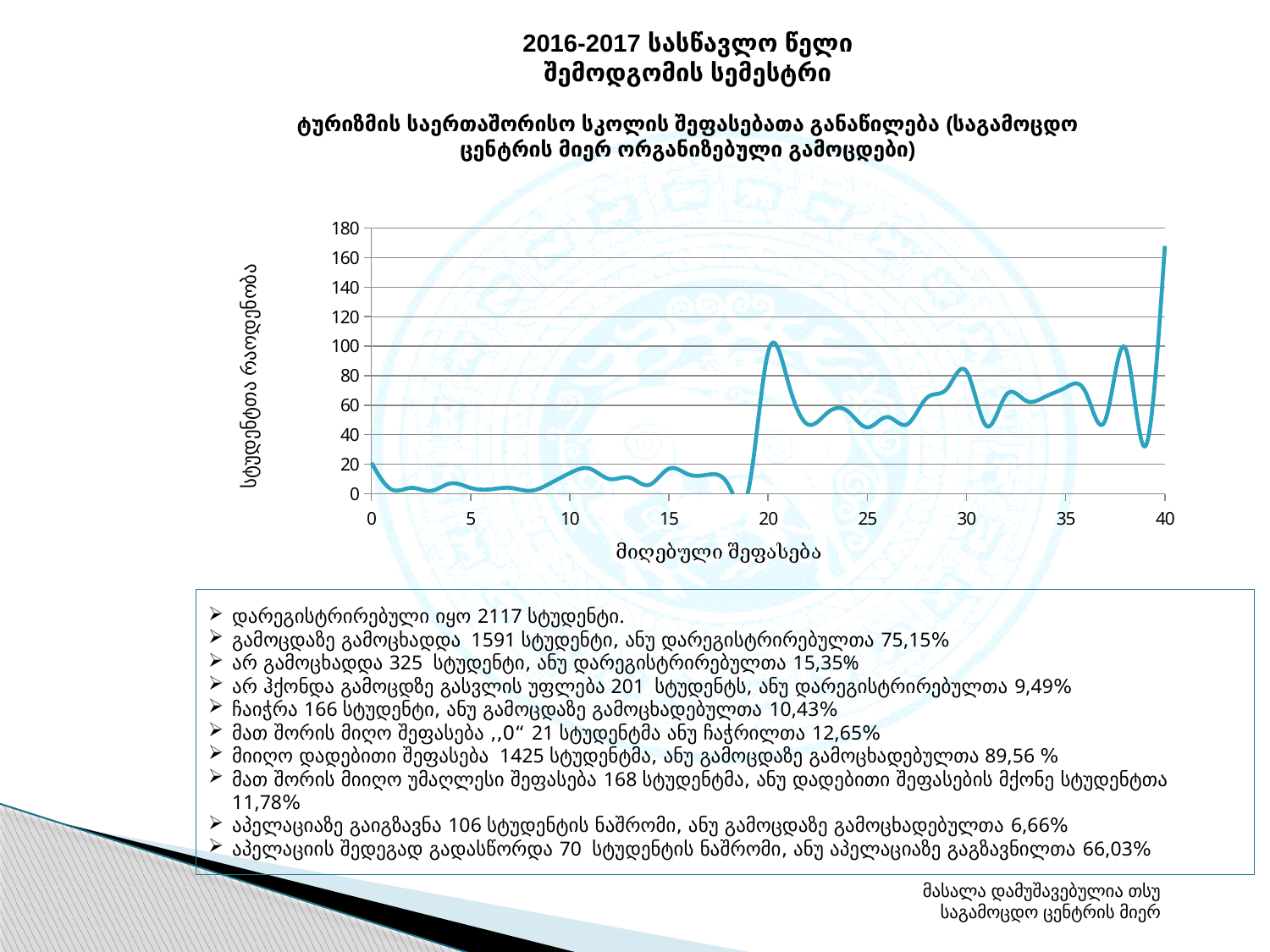
Is the value at x = 25 greater or less than 100? less What is the title of the x axis of the chart? მიღებული შეფასება Is the value at x = 5 greater or less than 20? less Is the value at x = 15 greater or less than 60? less Does the line rise or fall between x = 20 and x = 22? falls Does the line rise or fall between x = 18 and x = 20? rises What is the title of the y axis of the chart? სტუდენტთა რაოდენობა What kind of chart is shown on the slide? line chart